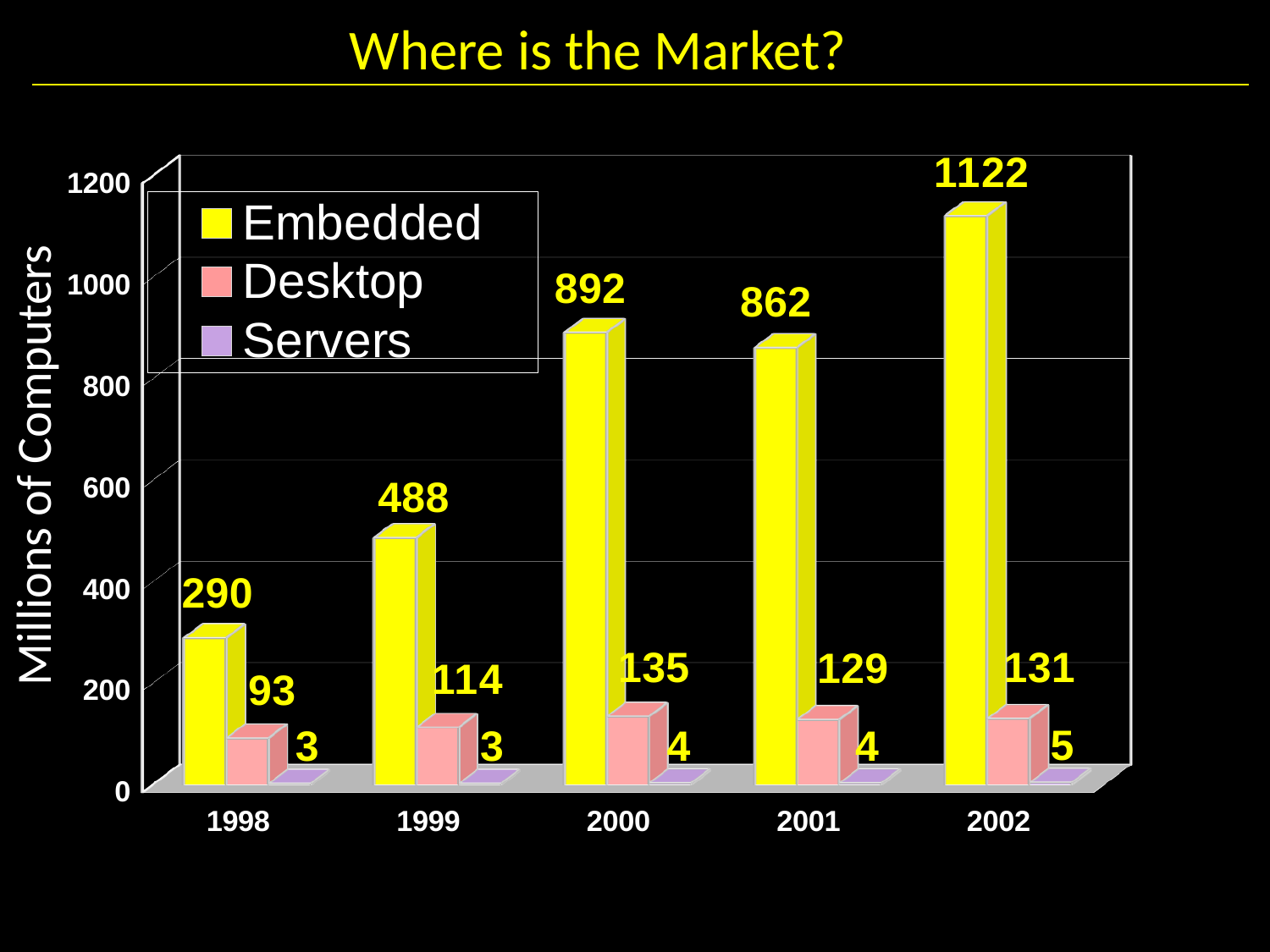
What is the y-axis label of the chart? Millions of Computers In which year is the Embedded value lowest? 1998 How many series does the legend list? 3 What is the value for Servers in 2002? 5 What is the difference between the Desktop values for 2000 and 1998? 42 What is the difference between the Embedded values for 2002 and 2001? 260 How many years are shown on the x axis? 5 What is the value for Desktop in 1999? 114 What kind of chart is shown on the slide? bar chart What is the value for Embedded in 2002? 1122 In which year is the Embedded value highest? 2002 Which is larger, the Embedded value for 2000 or for 2001? 2000